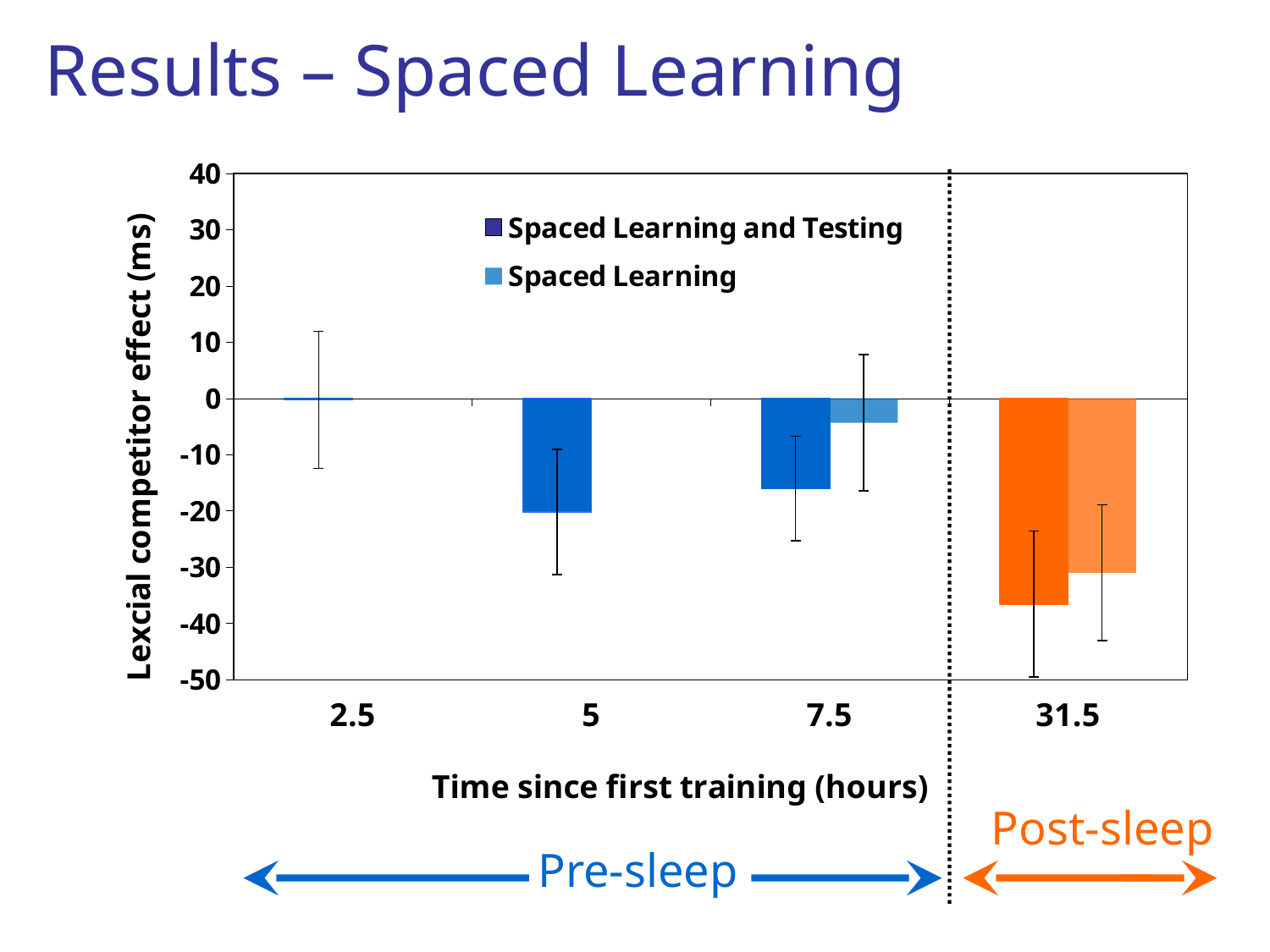
Is the value for Spaced Learning and Testing at 5 hours greater or less than -10? less Which series and time point has the lowest (most negative) lexical competitor effect? Spaced Learning and Testing at 31.5 hours Is the value for Spaced Learning and Testing at 31.5 hours greater or less than -30? less Is the value for Spaced Learning at 31.5 hours greater or less than -20? less Which time point on the x axis is marked as post-sleep? 31.5 At 7.5 hours, which series has the more negative lexical competitor effect? Spaced Learning and Testing What is the label of the y axis? Lexcial competitor effect (ms) How many series does the legend list? 2 What kind of chart is shown on the slide? bar chart How many time points are shown on the x axis? 4